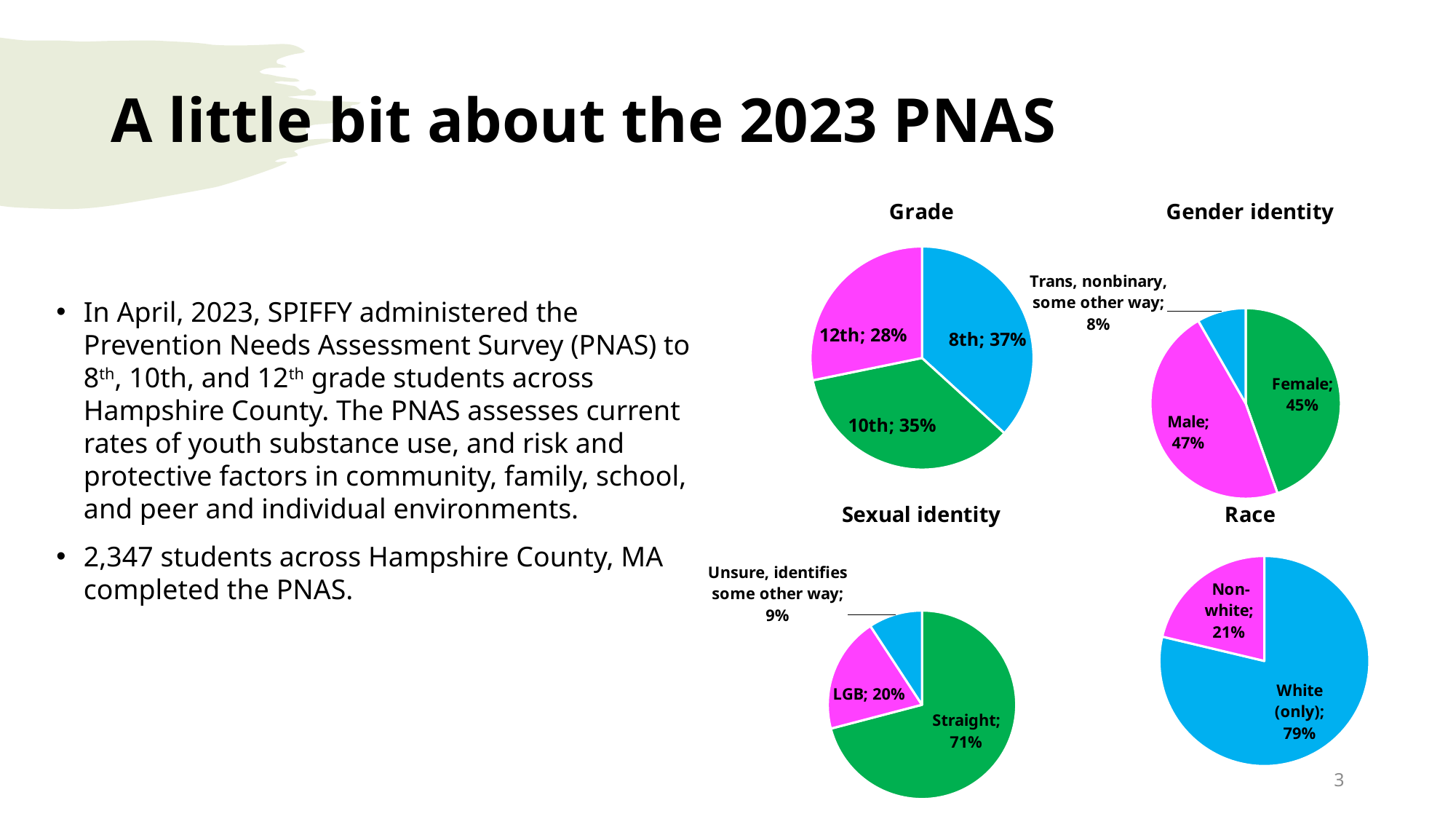
In the Sexual identity chart, what share of students are Straight? 71% In the Grade chart, which grade has the smallest share? 12th In the Race chart, what share of students are Non-white? 21% How many slices does the Sexual identity chart have? 3 What type of chart is the Race chart? Pie chart In the Sexual identity chart, which is larger, the LGB share or the 'Unsure, identifies some other way' share? LGB In the Gender identity chart, what share is labelled 'Trans, nonbinary, some other way'? 8% In the Race chart, what is the difference between the White (only) share and the Non-white share? 58% In the Gender identity chart, what share of students identify as Male? 47% In the Gender identity chart, which category has the largest share? Male In the Grade chart, what share of students are in 8th grade? 37% In the Grade chart, what is the difference between the 8th grade share and the 12th grade share? 9%